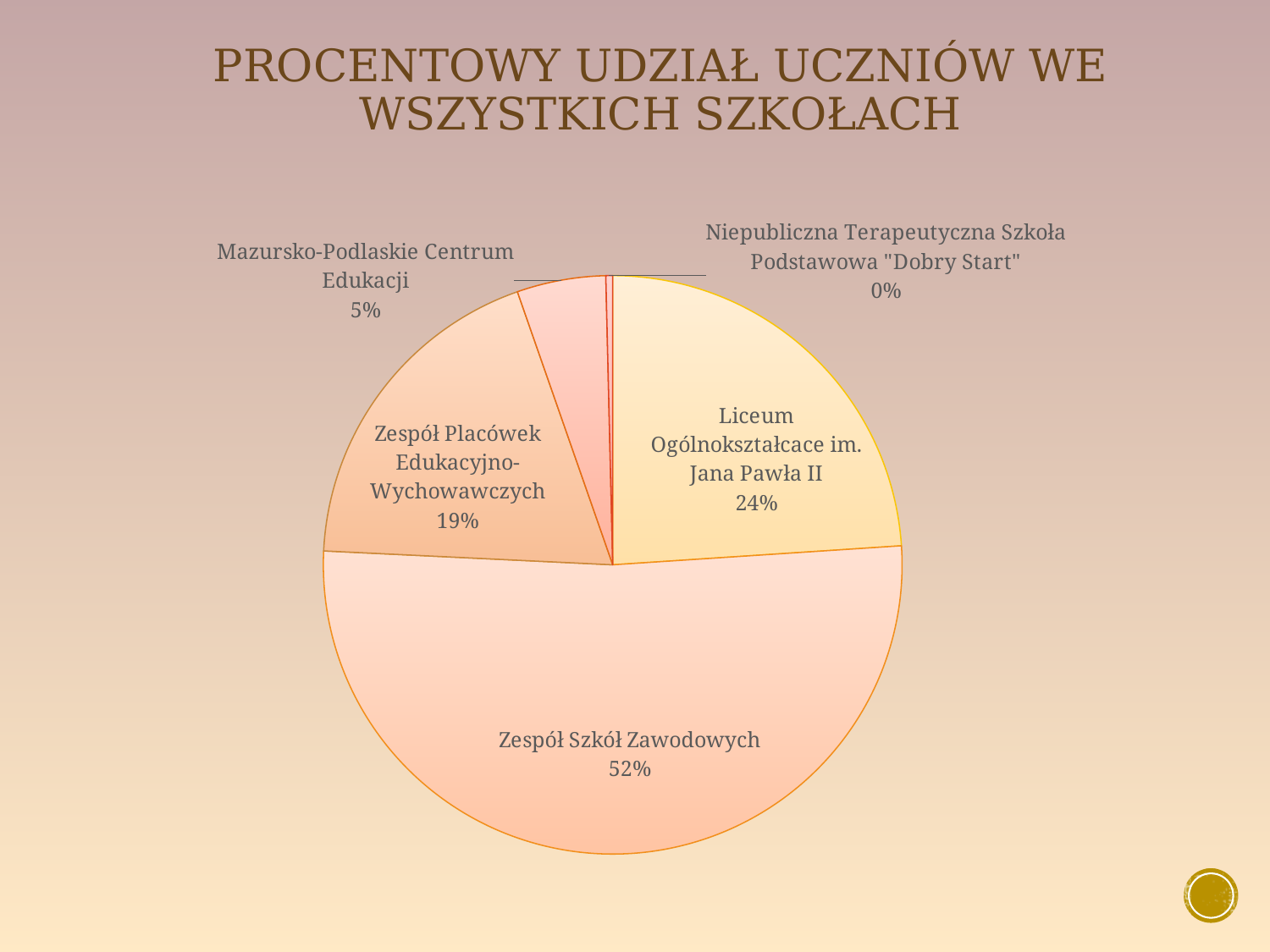
What percentage share does Mazursko-Podlaskie Centrum Edukacji have? 5% What is the difference in percentage points between Zespół Szkół Zawodowych and Liceum Ogólnokształcace im. Jana Pawła II? 28 What percentage share does Niepubliczna Terapeutyczna Szkoła Podstawowa "Dobry Start" have? 0% Which school has the largest share of students? Zespół Szkół Zawodowych What kind of chart is shown on the slide? pie chart Which has a larger share, Zespół Placówek Edukacyjno-Wychowawczych or Mazursko-Podlaskie Centrum Edukacji? Zespół Placówek Edukacyjno-Wychowawczych What percentage share does Zespół Placówek Edukacyjno-Wychowawczych have? 19% What percentage share does Zespół Szkół Zawodowych have? 52% What is the title of the chart? PROCENTOWY UDZIAŁ UCZNIÓW WE WSZYSTKICH SZKOŁACH Which school has the smallest share of students? Niepubliczna Terapeutyczna Szkoła Podstawowa "Dobry Start" How many schools (slices) are shown in the pie chart? 5 What percentage share does Liceum Ogólnokształcace im. Jana Pawła II have? 24%